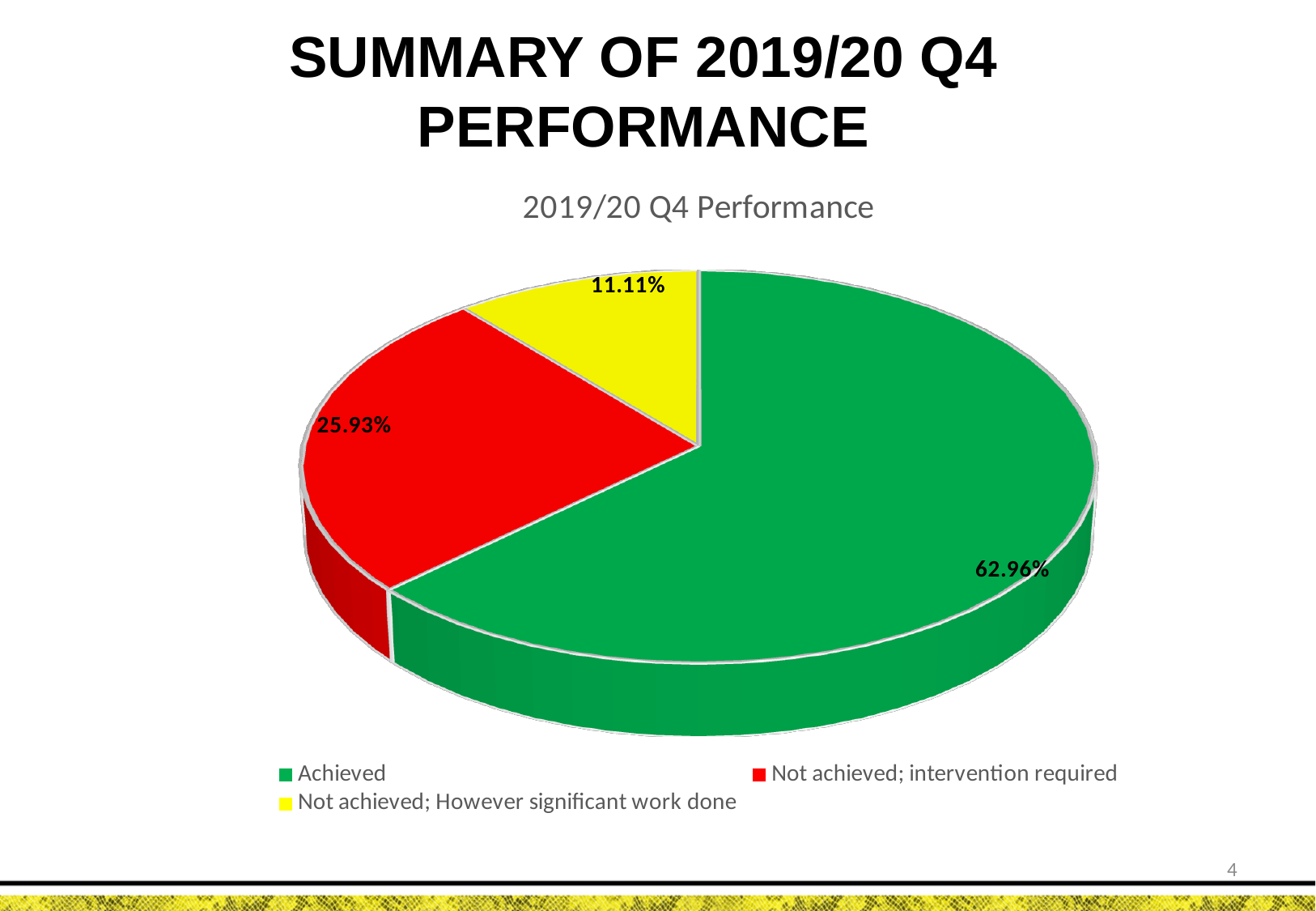
What percentage of the pie is labelled 'Not achieved; However significant work done'? 11.11% Which category has the largest share of the pie? Achieved Which category has the smallest share of the pie? Not achieved; However significant work done Which is larger: the share for 'Not achieved; intervention required' or the share for 'Not achieved; However significant work done'? Not achieved; intervention required What is the difference in percentage points between 'Achieved' and 'Not achieved; intervention required'? 37.03 What percentage of the pie is labelled 'Not achieved; intervention required'? 25.93% What is the title of the chart? 2019/20 Q4 Performance How many entries does the legend list? 3 What colour is the 'Achieved' slice? Green How many slices does the pie chart have? 3 What type of chart is shown on the slide? Pie chart What percentage of the pie is labelled 'Achieved'? 62.96%